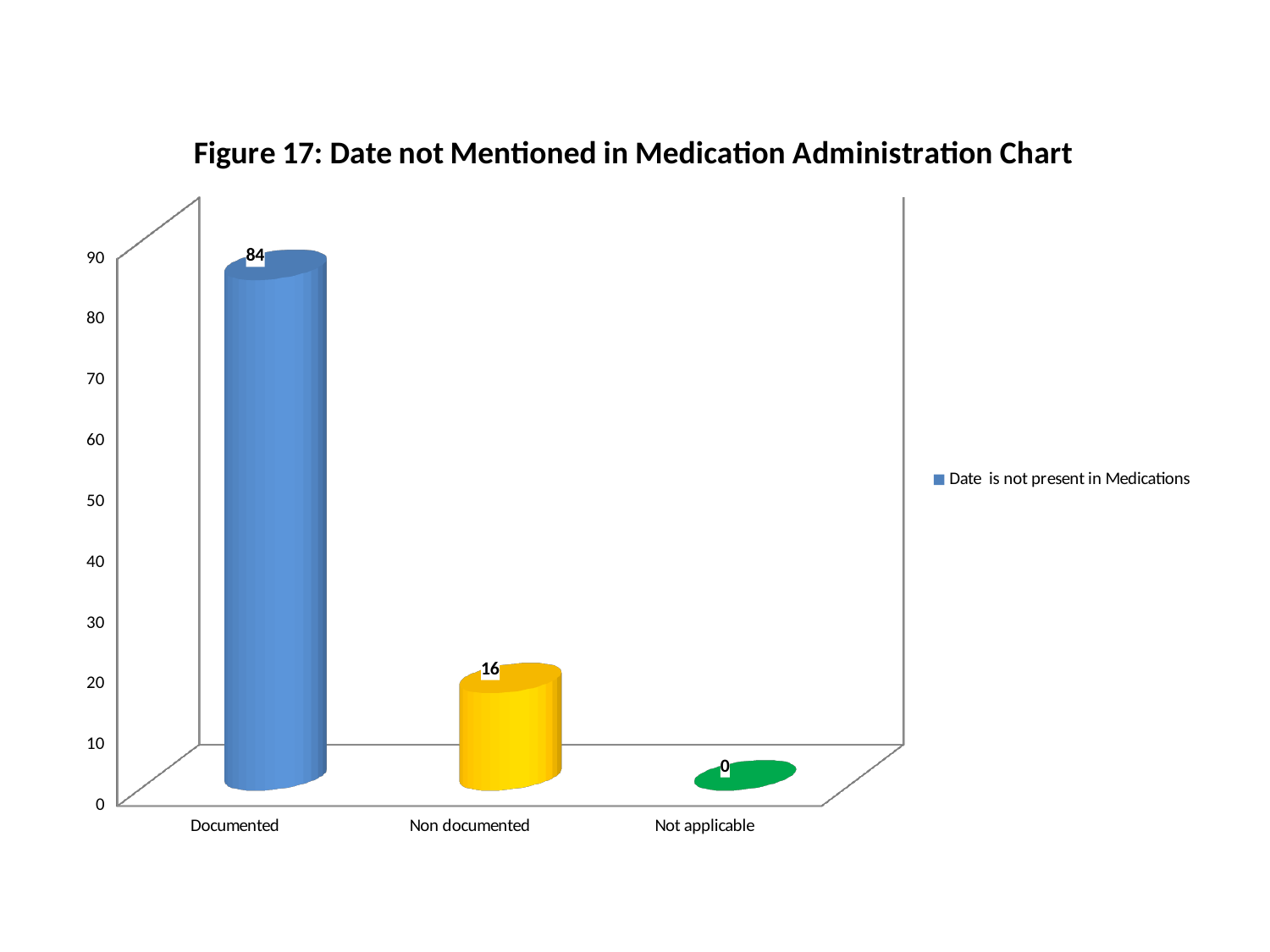
What is the value for Not applicable? 0 Which category has the highest value? Documented What is the title of the chart? Figure 17: Date not Mentioned in Medication Administration Chart What is the difference between the values for Documented and Non documented? 68 What is the value for Documented? 84 Is the value for Documented greater or less than 50? greater How many categories are shown on the x axis? 3 What is the value for Non documented? 16 How many series does the legend list? 1 Which category has the lowest value? Not applicable Which is larger, the value for Non documented or the value for Not applicable? Non documented What kind of chart is shown on the slide? bar chart